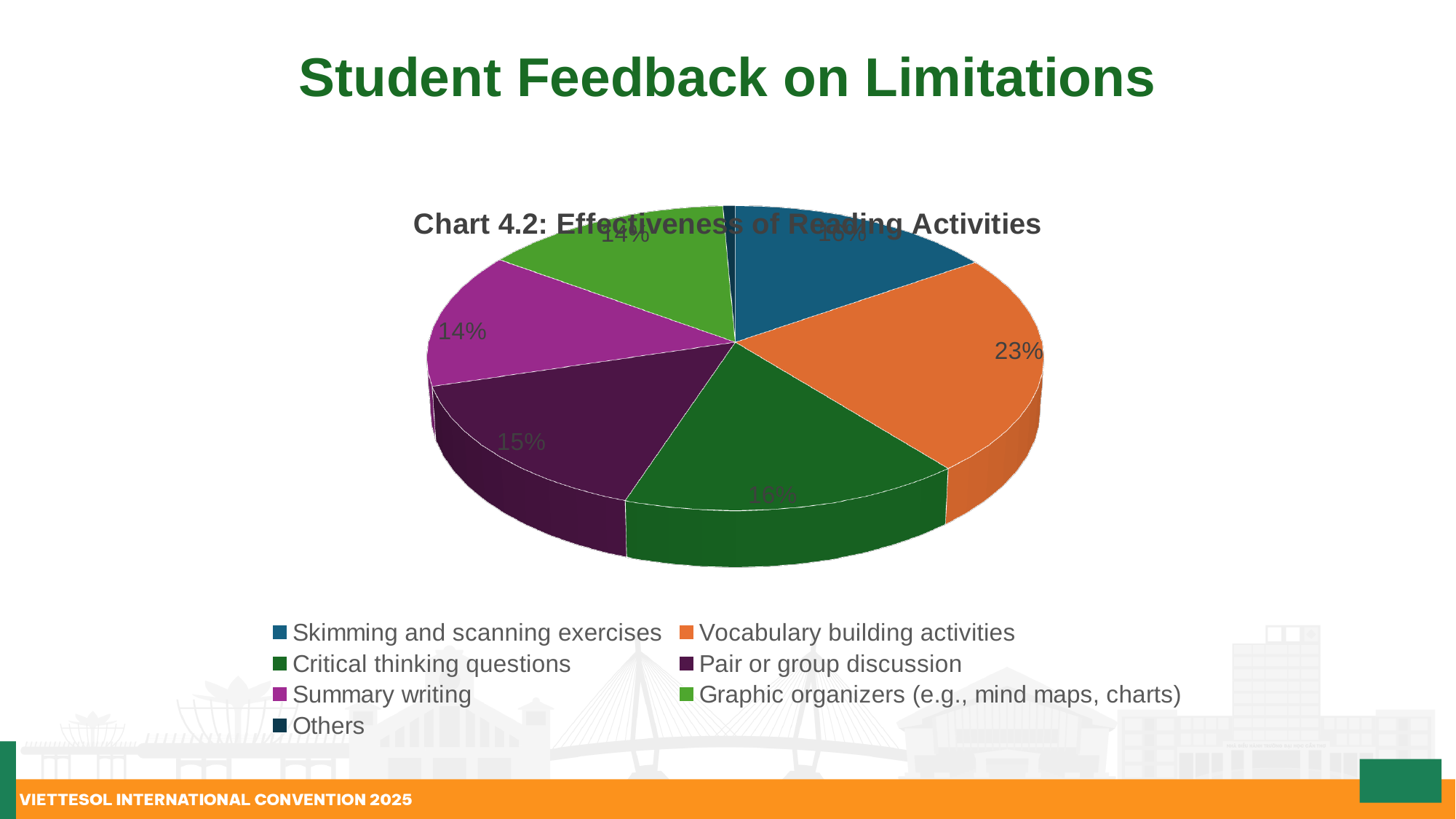
How many percentage points larger is Vocabulary building activities than Critical thinking questions? 7% Which category has the smallest share of the pie? Others What percentage is shown for Pair or group discussion? 15% What colour is the Vocabulary building activities slice? Orange Which category has the largest share of the pie? Vocabulary building activities What percentage is shown for Critical thinking questions? 16% Which has the larger share: Pair or group discussion or Summary writing? Pair or group discussion What percentage of the pie is Vocabulary building activities? 23% How many categories does the legend list? 7 What kind of chart is shown on the slide? Pie chart What is the title of the chart? Chart 4.2: Effectiveness of Reading Activities What percentage is shown for Summary writing? 14%